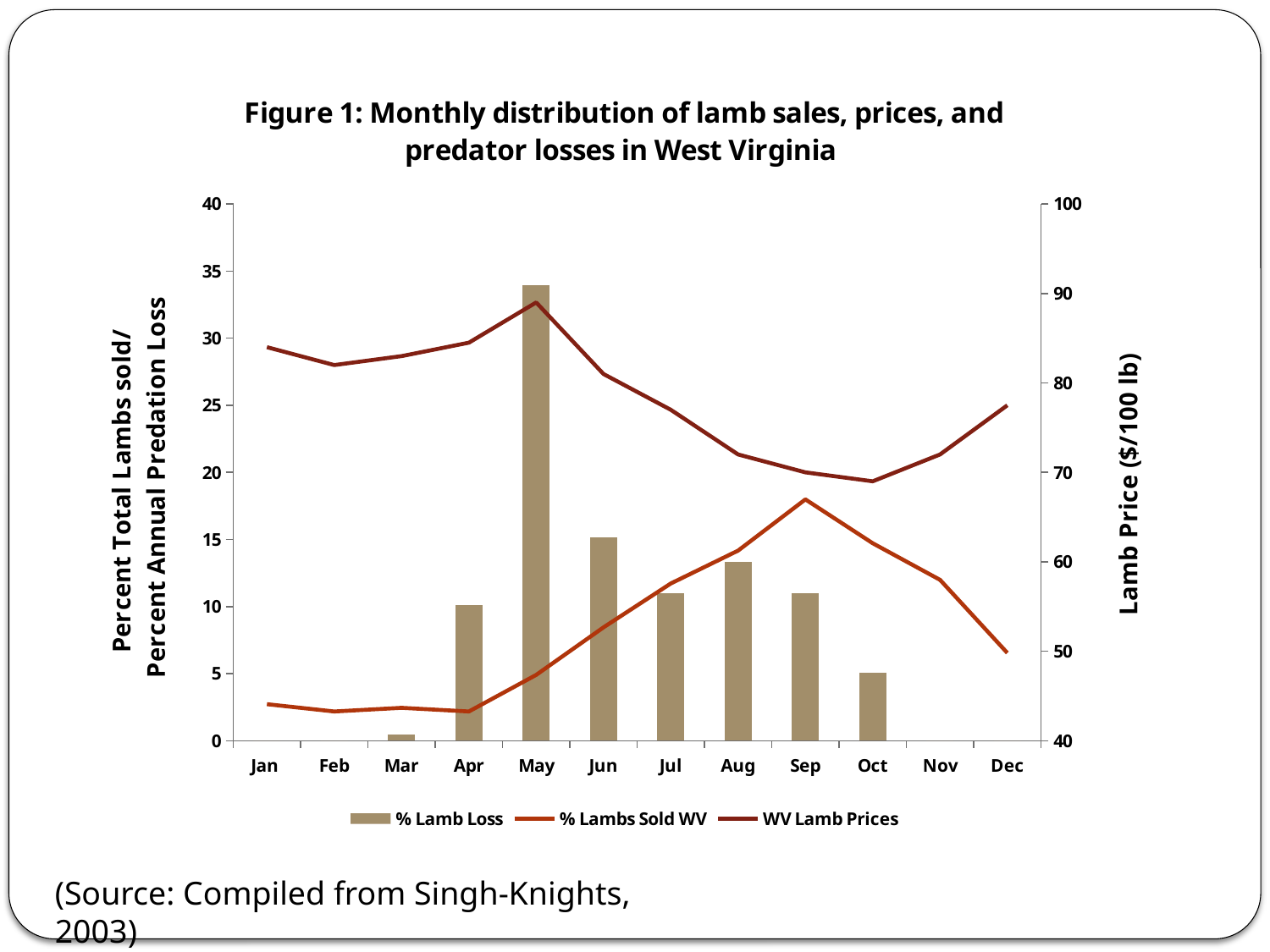
Is the WV Lamb Prices value for Jan greater or less than 80? greater In which month is the WV Lamb Prices line at its highest? May In which month is the WV Lamb Prices line at its lowest? Oct Does the WV Lamb Prices line rise or fall from May to Oct? fall In which month does the % Lambs Sold WV line reach its highest point? Sep How many months are shown along the x axis? 12 Which month has the larger % Lamb Loss bar, Jun or Oct? Jun Is the % Lambs Sold WV value for Sep greater or less than 15? greater What kind of chart is shown on the slide? A combined bar and line chart How many series does the legend list? 3 In which month is the % Lamb Loss bar highest? May Is the % Lamb Loss value for May greater or less than 30? greater